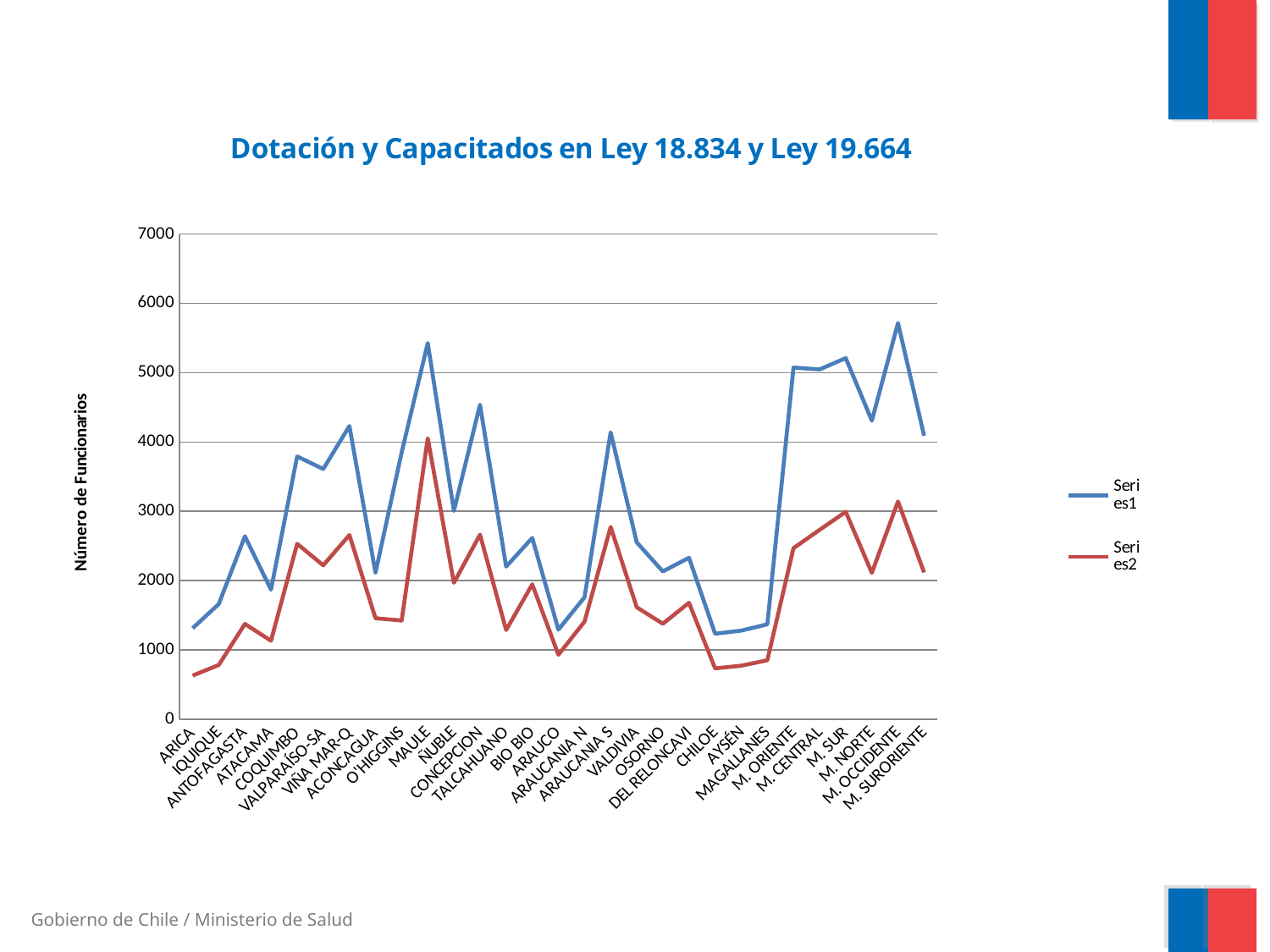
How many series does the legend list? 2 What is the label of the vertical axis? Número de Funcionarios What kind of chart is shown on the slide? line chart At MAULE, which series has the larger value, Series1 or Series2? Series1 For Series1, which is larger, the value for MAULE or the value for ÑUBLE? MAULE How many categories are plotted along the x axis? 29 Is the Series2 value for ARICA greater or less than 1000? less Which category has the highest value for Series2? MAULE What is the title of the chart? Dotación y Capacitados en Ley 18.834 y Ley 19.664 Is the Series1 value for MAULE greater or less than 5000? greater Is the Series1 value for CONCEPCION greater or less than 4000? greater Which category has the highest value for Series1? M. OCCIDENTE